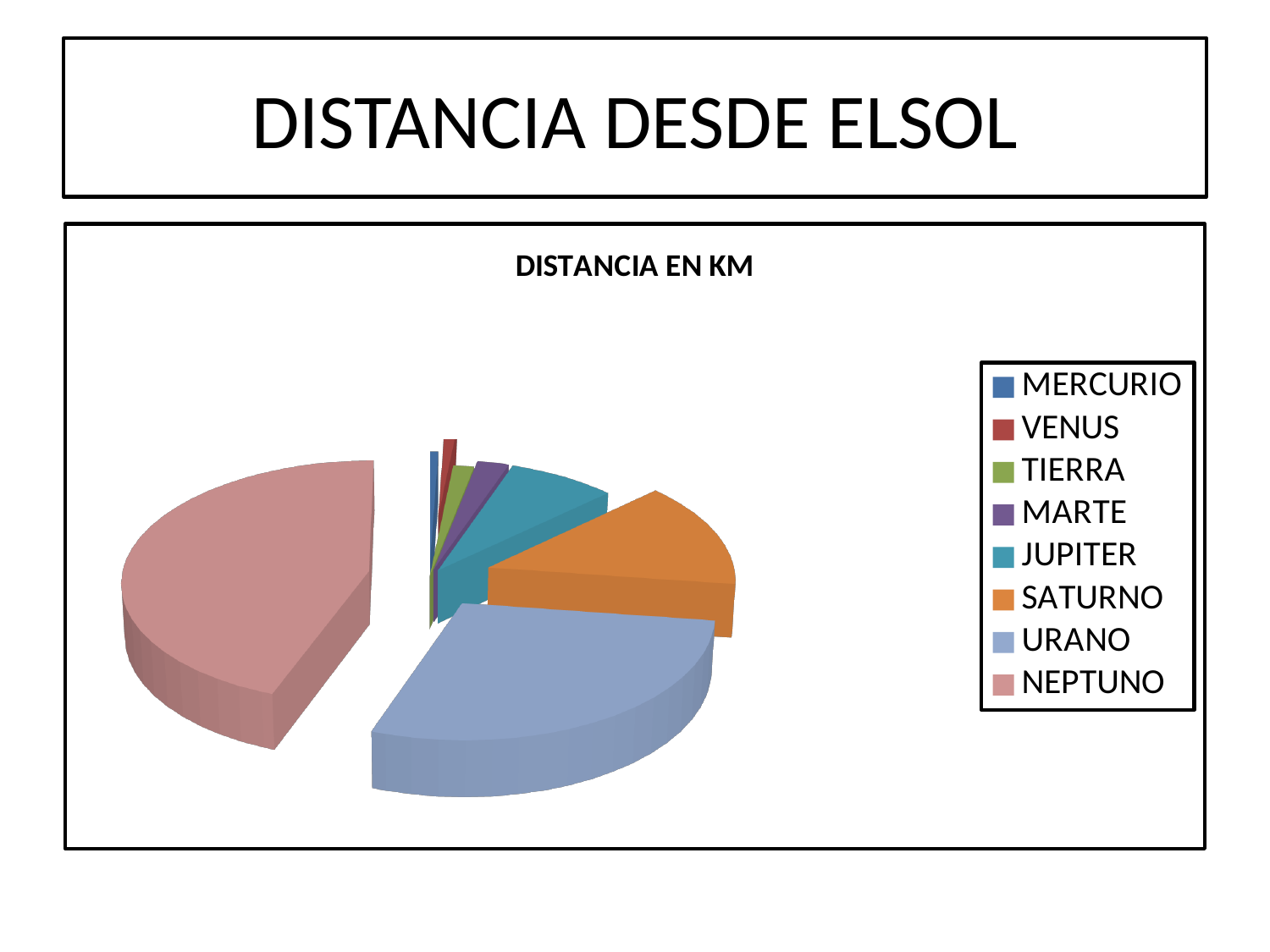
What kind of chart is shown on the slide? pie chart What is the title of the chart? DISTANCIA EN KM Which category has the smallest slice of the pie? MERCURIO Which slice is larger, JUPITER or MARTE? JUPITER Which category has the largest slice of the pie? NEPTUNO Which slice is larger, URANO or SATURNO? URANO Which slice is larger, SATURNO or JUPITER? SATURNO How many categories does the pie chart have? 8 Which category is listed last in the legend? NEPTUNO